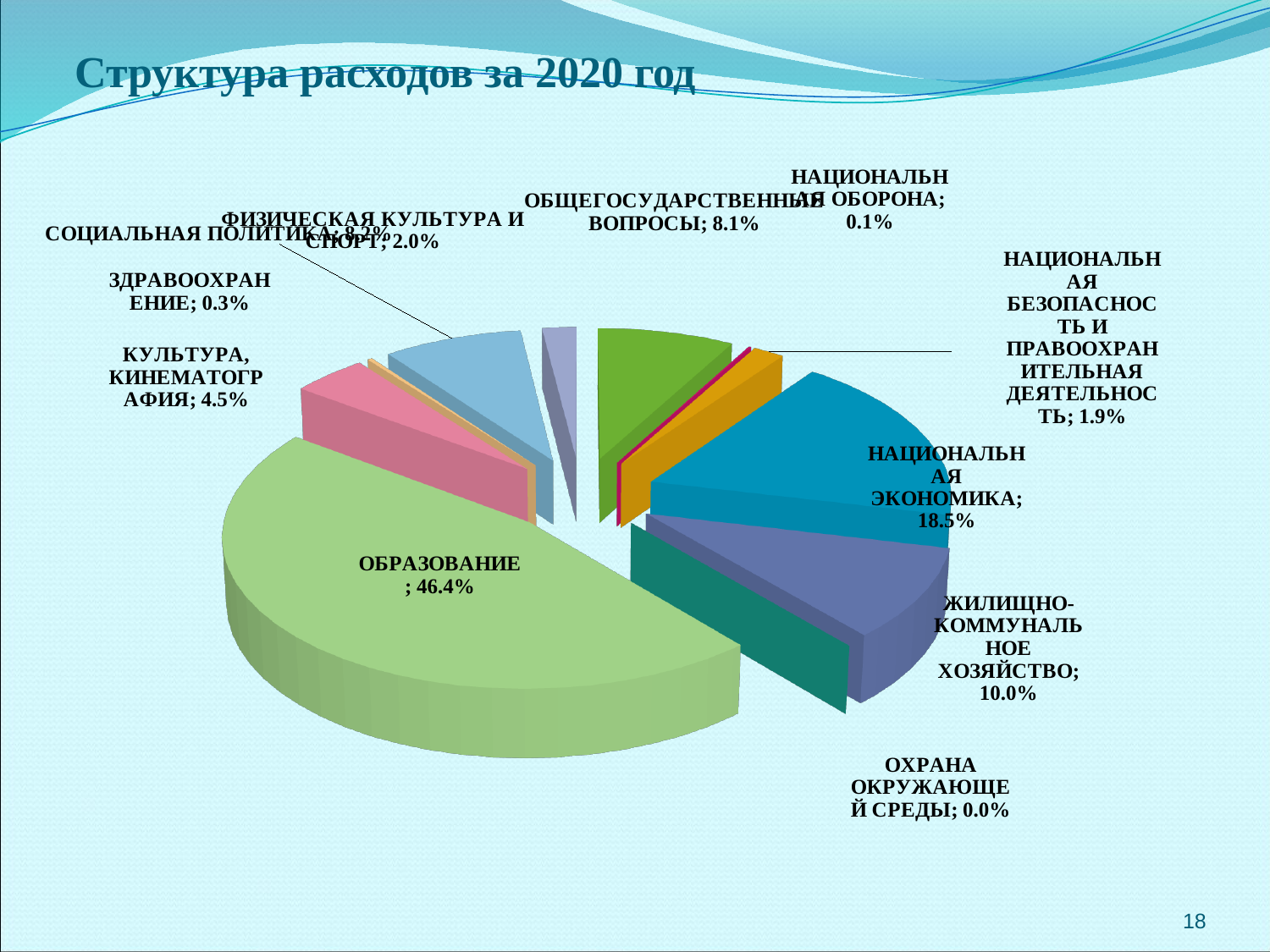
What share of expenditures goes to НАЦИОНАЛЬНАЯ ЭКОНОМИКА? 18.5% What share of expenditures goes to ОБЩЕГОСУДАРСТВЕННЫЕ ВОПРОСЫ? 8.1% What share of expenditures goes to КУЛЬТУРА, КИНЕМАТОГРАФИЯ? 4.5% Which category has the largest share of expenditures? ОБРАЗОВАНИЕ What share of expenditures goes to ОБРАЗОВАНИЕ? 46.4% What is the title of the chart? Структура расходов за 2020 год Which category has the smallest share of expenditures? ОХРАНА ОКРУЖАЮЩЕЙ СРЕДЫ What kind of chart is shown on the slide? Pie chart What share of expenditures goes to ЖИЛИЩНО-КОММУНАЛЬНОЕ ХОЗЯЙСТВО? 10.0% Which is larger: the share for ЖИЛИЩНО-КОММУНАЛЬНОЕ ХОЗЯЙСТВО or for ОБЩЕГОСУДАРСТВЕННЫЕ ВОПРОСЫ? ЖИЛИЩНО-КОММУНАЛЬНОЕ ХОЗЯЙСТВО What is the difference in percentage points between ОБРАЗОВАНИЕ and НАЦИОНАЛЬНАЯ ЭКОНОМИКА? 27.9 What share of expenditures goes to НАЦИОНАЛЬНАЯ ОБОРОНА? 0.1%